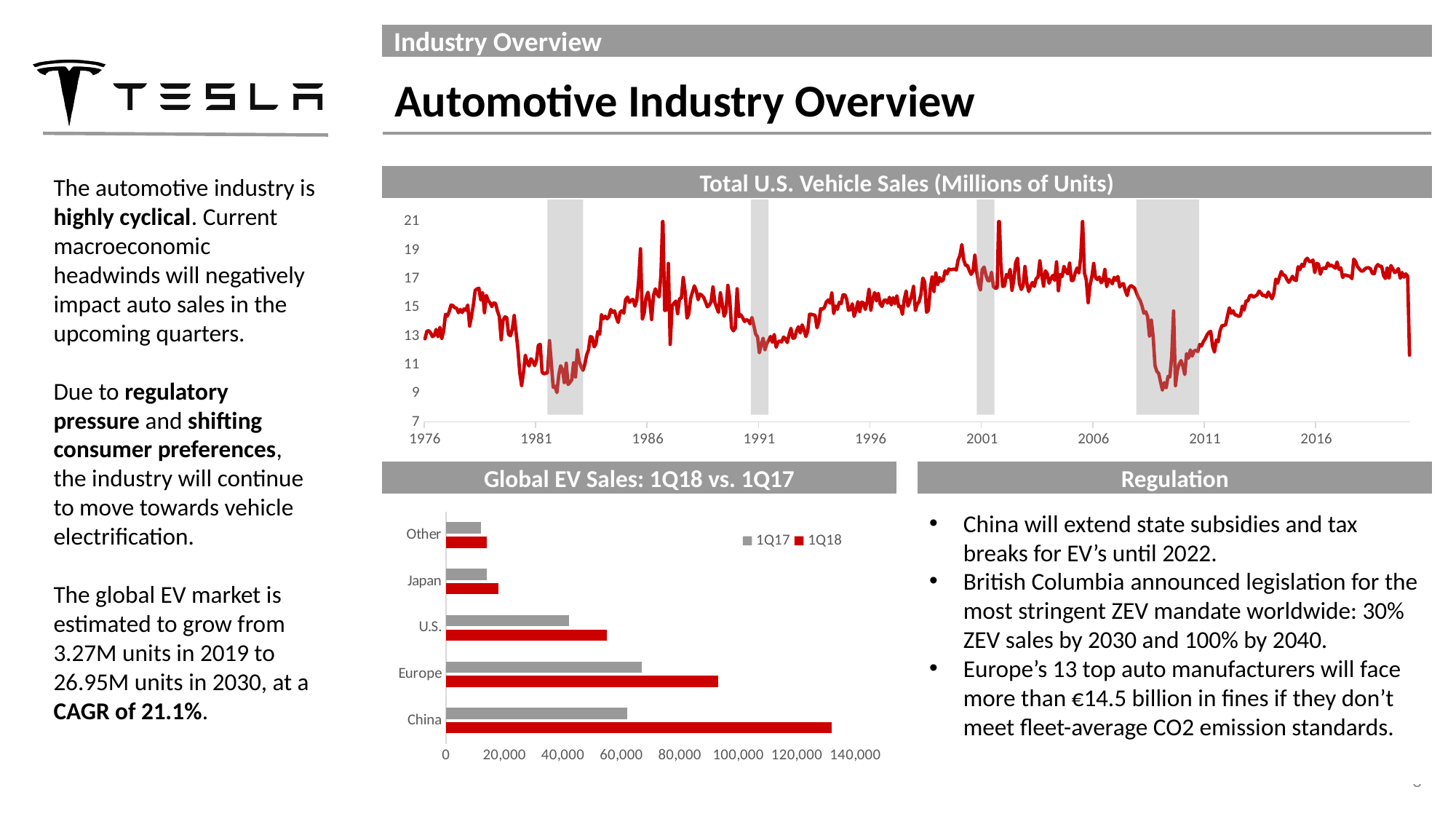
In the 'Total U.S. Vehicle Sales (Millions of Units)' chart, is the lowest value around 2009 greater or less than 11? less In the 'Global EV Sales: 1Q18 vs. 1Q17' chart, is the 1Q18 value for China greater or less than 120,000? greater In the 'Global EV Sales: 1Q18 vs. 1Q17' chart, which is larger for the U.S., the 1Q17 value or the 1Q18 value? 1Q18 In the 'Global EV Sales: 1Q18 vs. 1Q17' chart, how many regions are shown on the vertical axis? 5 In the 'Global EV Sales: 1Q18 vs. 1Q17' chart, how many series does the legend list? 2 In the 'Global EV Sales: 1Q18 vs. 1Q17' chart, is the 1Q18 value for Japan greater or less than 20,000? less What kind of chart is the 'Total U.S. Vehicle Sales (Millions of Units)' chart? line chart What kind of chart is the 'Global EV Sales: 1Q18 vs. 1Q17' chart? bar chart In the 'Global EV Sales: 1Q18 vs. 1Q17' chart, which region has the highest 1Q18 value? China In the 'Global EV Sales: 1Q18 vs. 1Q17' chart, which colour represents the 1Q17 series? grey